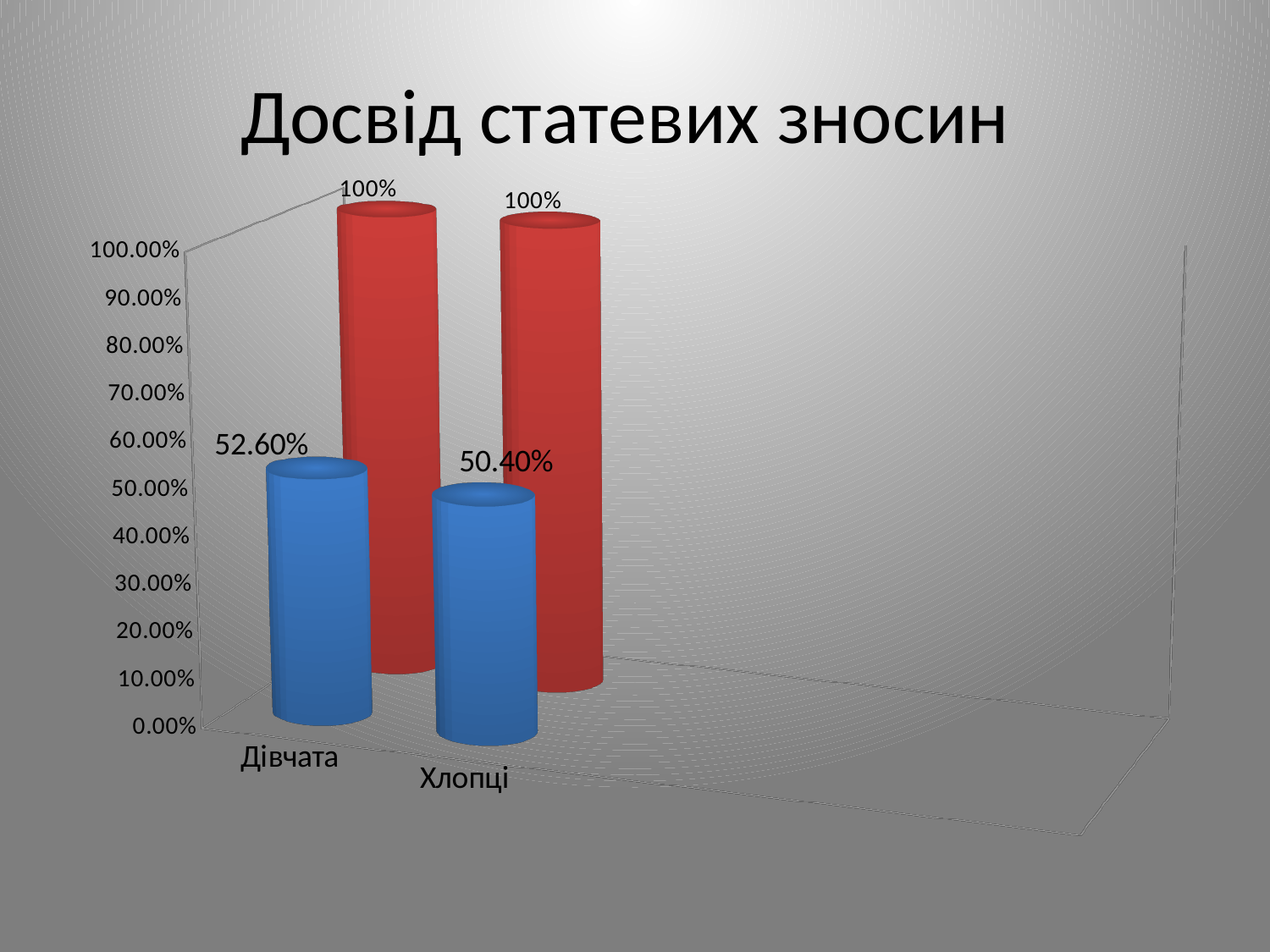
What colours are the two series of bars in the chart? blue and red Which category has the higher blue bar value, Дівчата or Хлопці? Дівчата What is the difference between the red bar and the blue bar for Хлопці? 49.60% What is the title of the chart? Досвід статевих зносин What is the value of the blue bar for Хлопці? 50.40% What is the value of the red bar for Хлопці? 100% Is the blue bar value for Хлопці greater or less than 60.00%? less What is the difference between the blue bar values for Дівчата and Хлопці? 2.20% How many categories are shown on the x axis of the chart? 2 What is the value of the red bar for Дівчата? 100% What is the value of the blue bar for Дівчата? 52.60% What type of chart is shown on the slide? bar chart